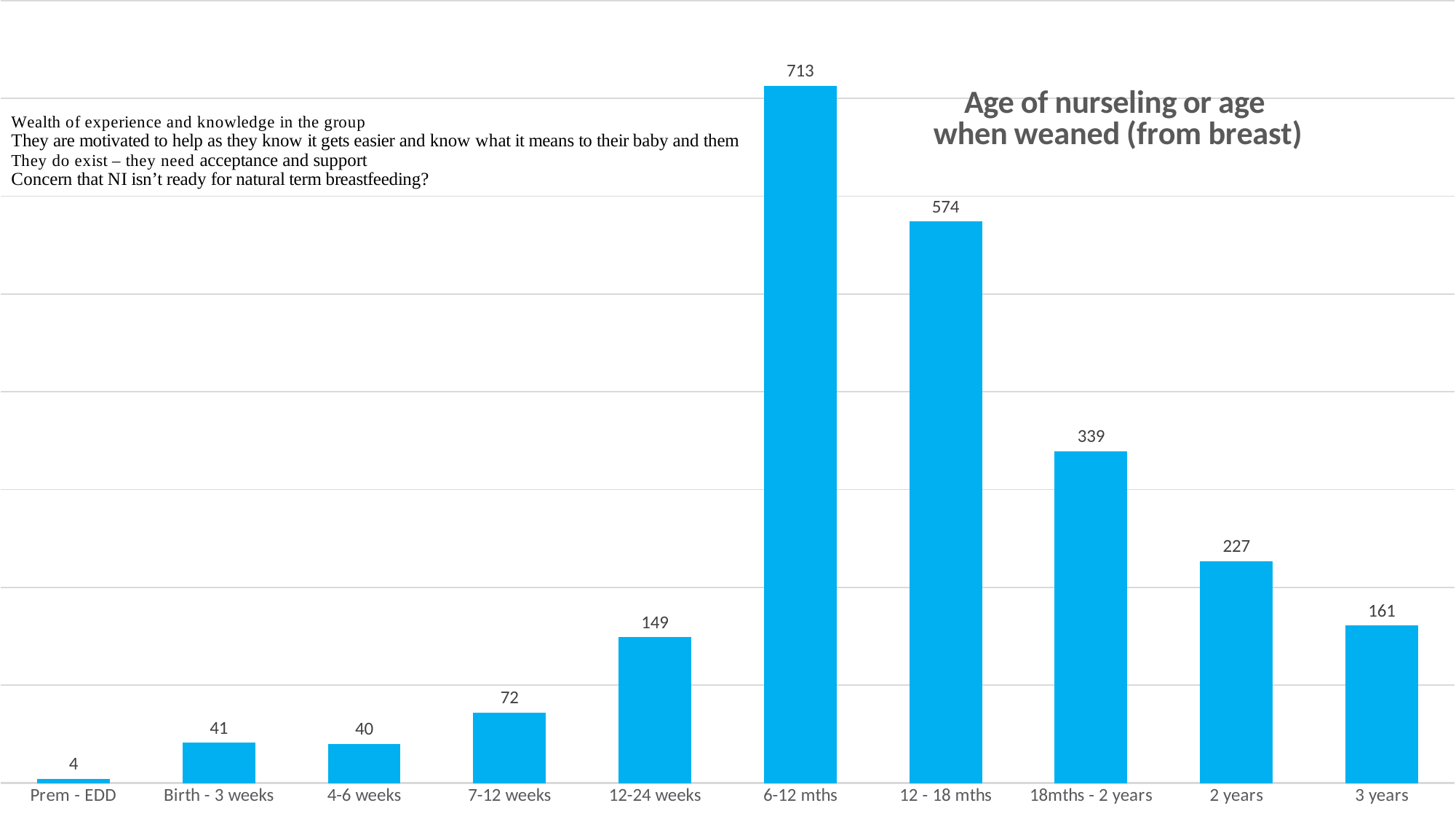
What kind of chart is shown on the slide? Bar chart What is the value for 18mths - 2 years? 339 What is the value for 3 years? 161 What is the difference between the values for 6-12 mths and 12 - 18 mths? 139 Which is larger, the value for 12-24 weeks or the value for 7-12 weeks? 12-24 weeks What is the difference between the values for 2 years and 3 years? 66 How many categories are shown on the x axis? 10 Which category has the highest value? 6-12 mths What is the value for 6-12 mths? 713 Which category has the lowest value? Prem - EDD Do the values rise or fall from Prem - EDD to 6-12 mths? Rise (with a slight dip from Birth - 3 weeks to 4-6 weeks) What is the title of the chart? Age of nurseling or age when weaned (from breast)